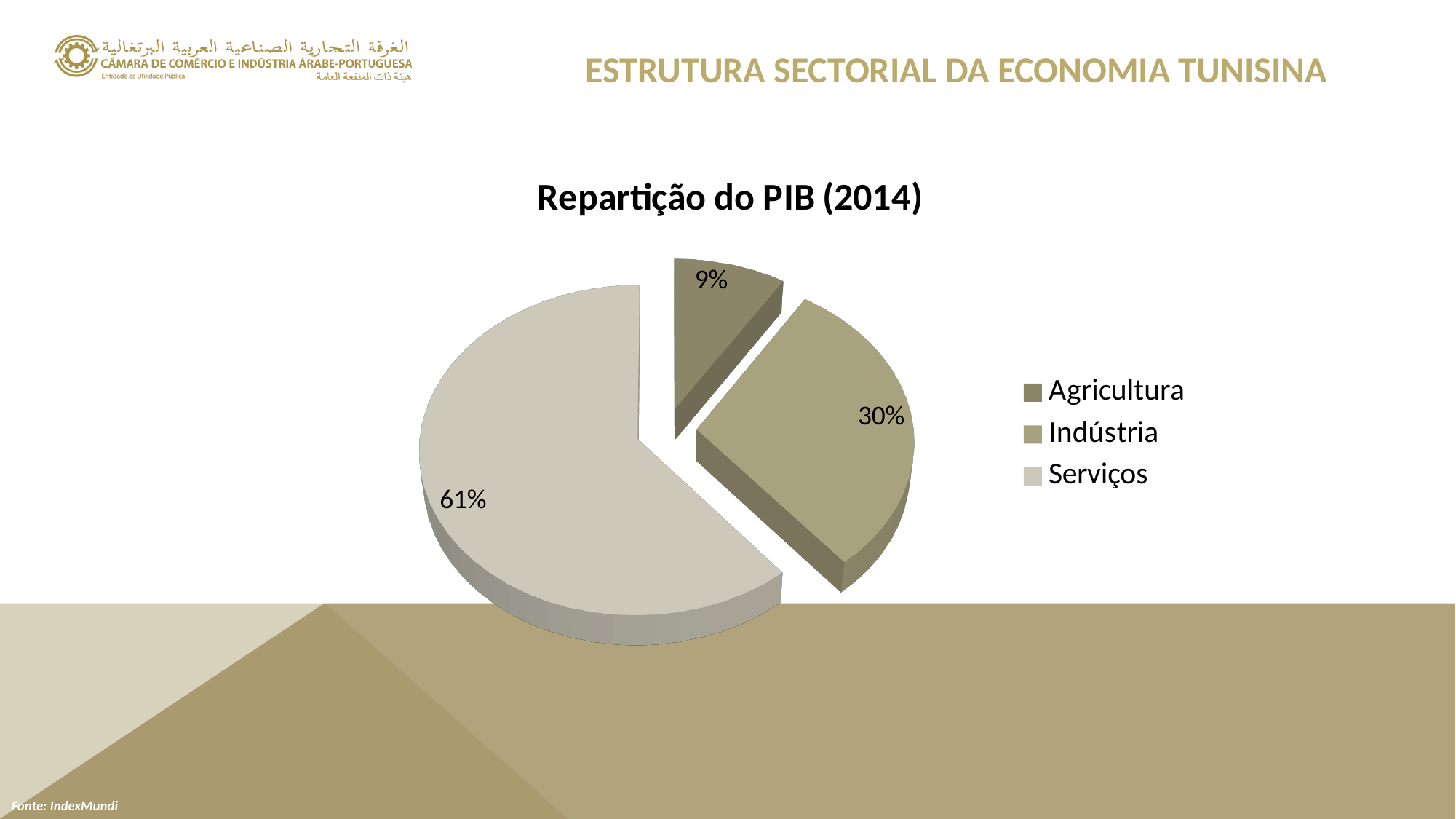
Which sector has the largest share of the pie? Serviços Which is larger, the share for Indústria or the share for Agricultura? Indústria What type of chart is shown on the slide? Pie chart What share of GDP does Agricultura account for in the pie chart? 9% What share of GDP does Indústria account for in the pie chart? 30% What share of GDP does Serviços account for in the pie chart? 61% What is the difference in percentage points between the Indústria and Agricultura shares? 21 What is the difference in percentage points between the Serviços and Indústria shares? 31 How many sectors are shown in the pie chart? 3 Which legend entry is shown with the lightest colour? Serviços What is the title of the chart? Repartição do PIB (2014) Which sector has the smallest share of the pie? Agricultura